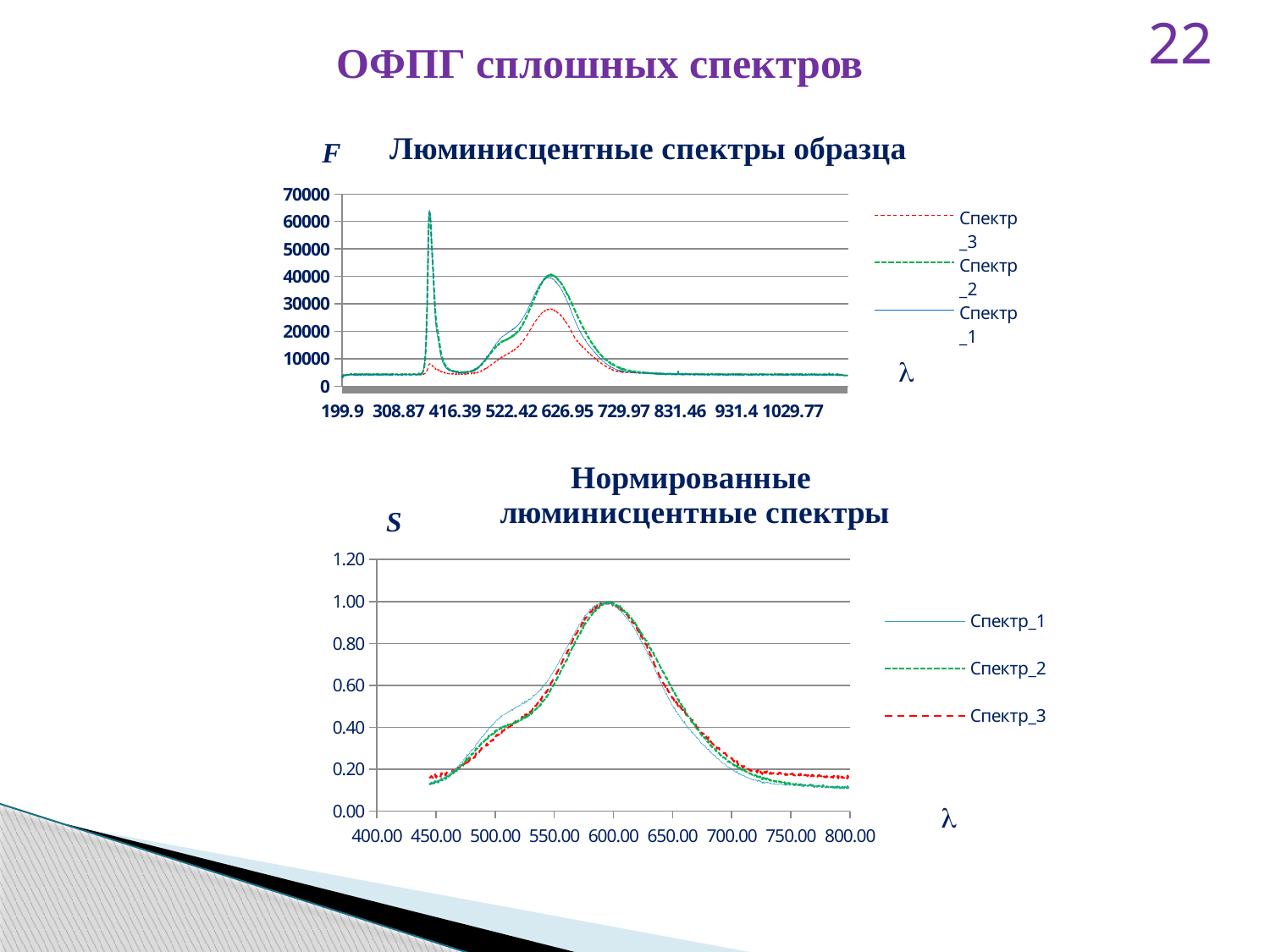
In the top chart "Люминисцентные спектры образца", is the highest value of Спектр_1 greater or less than 60000? greater What is the title of the top chart on the slide? Люминисцентные спектры образца How many series does the legend of the bottom chart "Нормированные люминисцентные спектры" list? 3 What kind of chart is the top chart titled "Люминисцентные спектры образца"? line chart What kind of chart is the bottom chart titled "Нормированные люминисцентные спектры"? line chart In the bottom chart "Нормированные люминисцентные спектры", do the values rise or fall between 600.00 and 700.00? fall In the top chart "Люминисцентные спектры образца", is the highest value of Спектр_3 greater or less than 30000? less In the bottom chart "Нормированные люминисцентные спектры", which series has the larger value at 800.00: Спектр_1 or Спектр_3? Спектр_3 In the bottom chart "Нормированные люминисцентные спектры", is the value of Спектр_3 at 800.00 greater or less than 0.20? less How many series does the legend of the top chart "Люминисцентные спектры образца" list? 3 In the top chart "Люминисцентные спектры образца", which series has the lower peak around 626.95: Спектр_2 or Спектр_3? Спектр_3